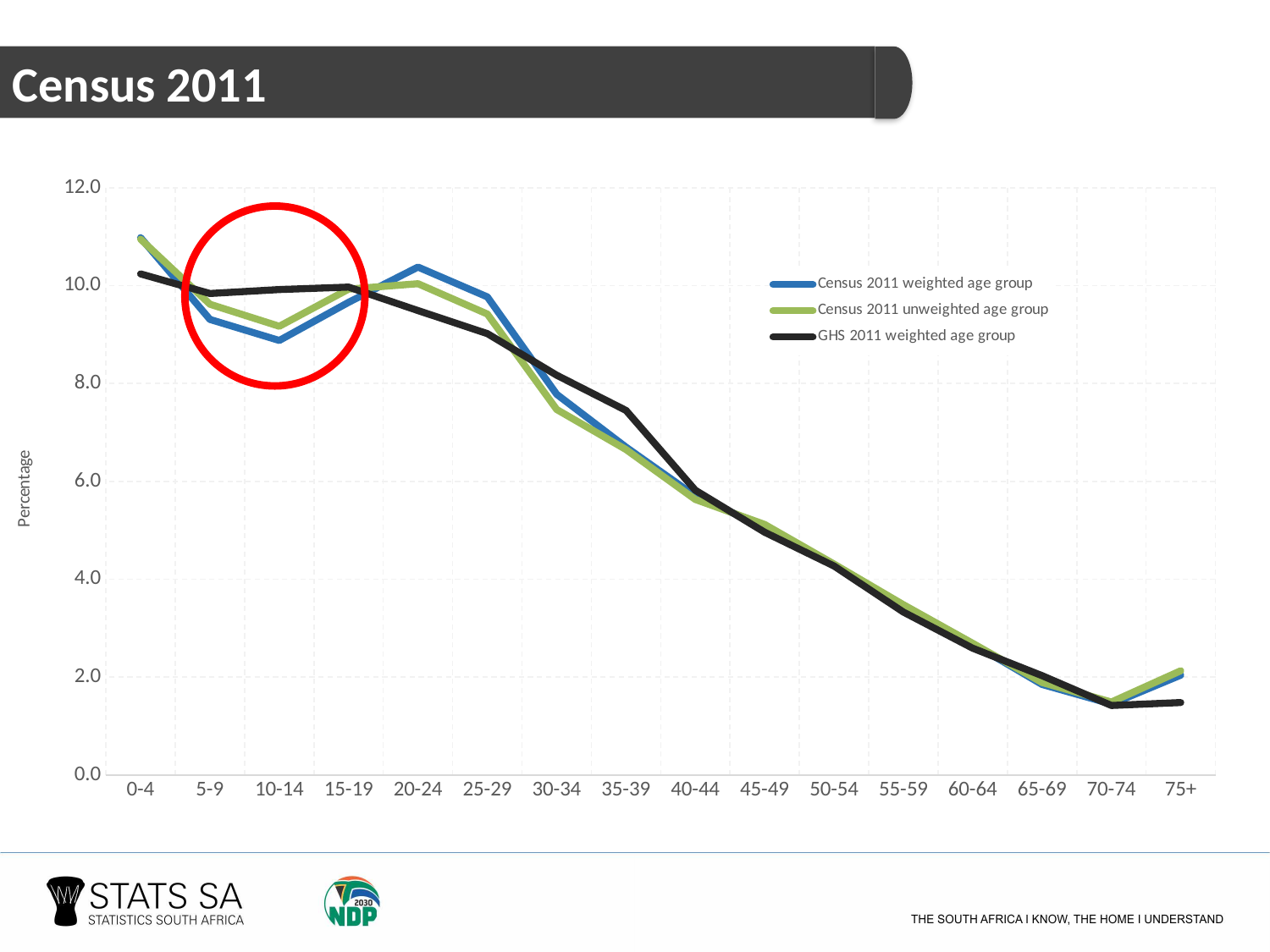
Is the value for Census 2011 weighted age group at 10-14 greater or less than 10.0? less Is the value for Census 2011 weighted age group at 0-4 greater or less than 10.0? greater Do the values generally rise or fall from the 0-4 age group to the 70-74 age group? Fall What is the label on the y axis? Percentage At 10-14, which series has the larger value: GHS 2011 weighted age group or Census 2011 weighted age group? GHS 2011 weighted age group How many series does the legend list? 3 What kind of chart is shown on the slide? Line chart Which age group has the lowest value for the Census 2011 weighted age group series? 70-74 Is the value for GHS 2011 weighted age group at 35-39 greater or less than 8.0? less Which age group has the highest value for the Census 2011 weighted age group series? 0-4 How many age-group categories are shown on the x axis? 16